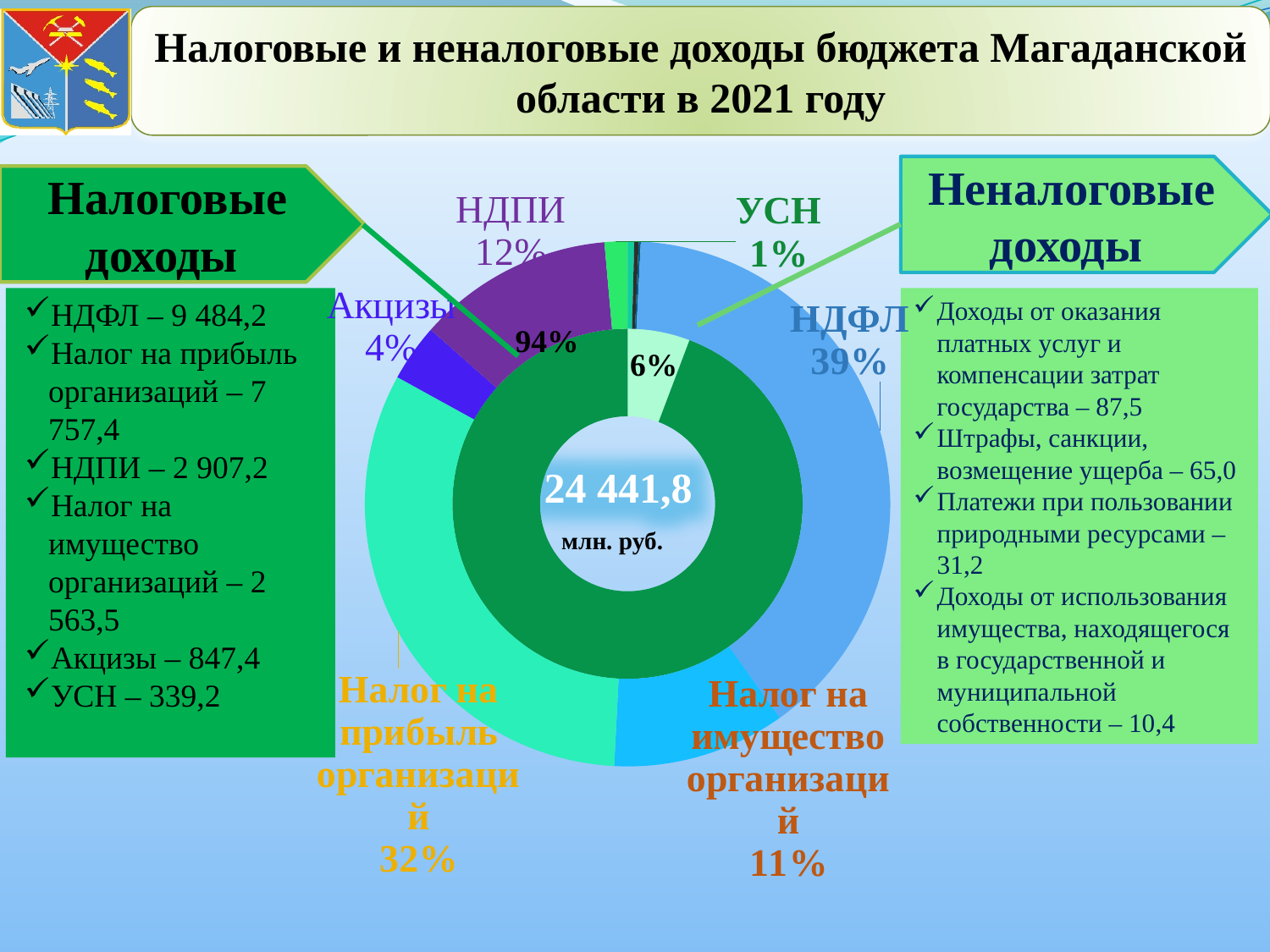
What share of the outer ring does Налог на прибыль организаций account for? 32% What share of the outer ring does НДФЛ account for? 39% Which category has the largest share in the outer ring? НДФЛ What kind of chart is shown on the slide? doughnut chart What share of the outer ring does УСН account for? 1% What total value is shown in the centre of the chart? 24 441,8 млн. руб. What is the difference in percentage points between the НДФЛ share and the Налог на прибыль организаций share? 7